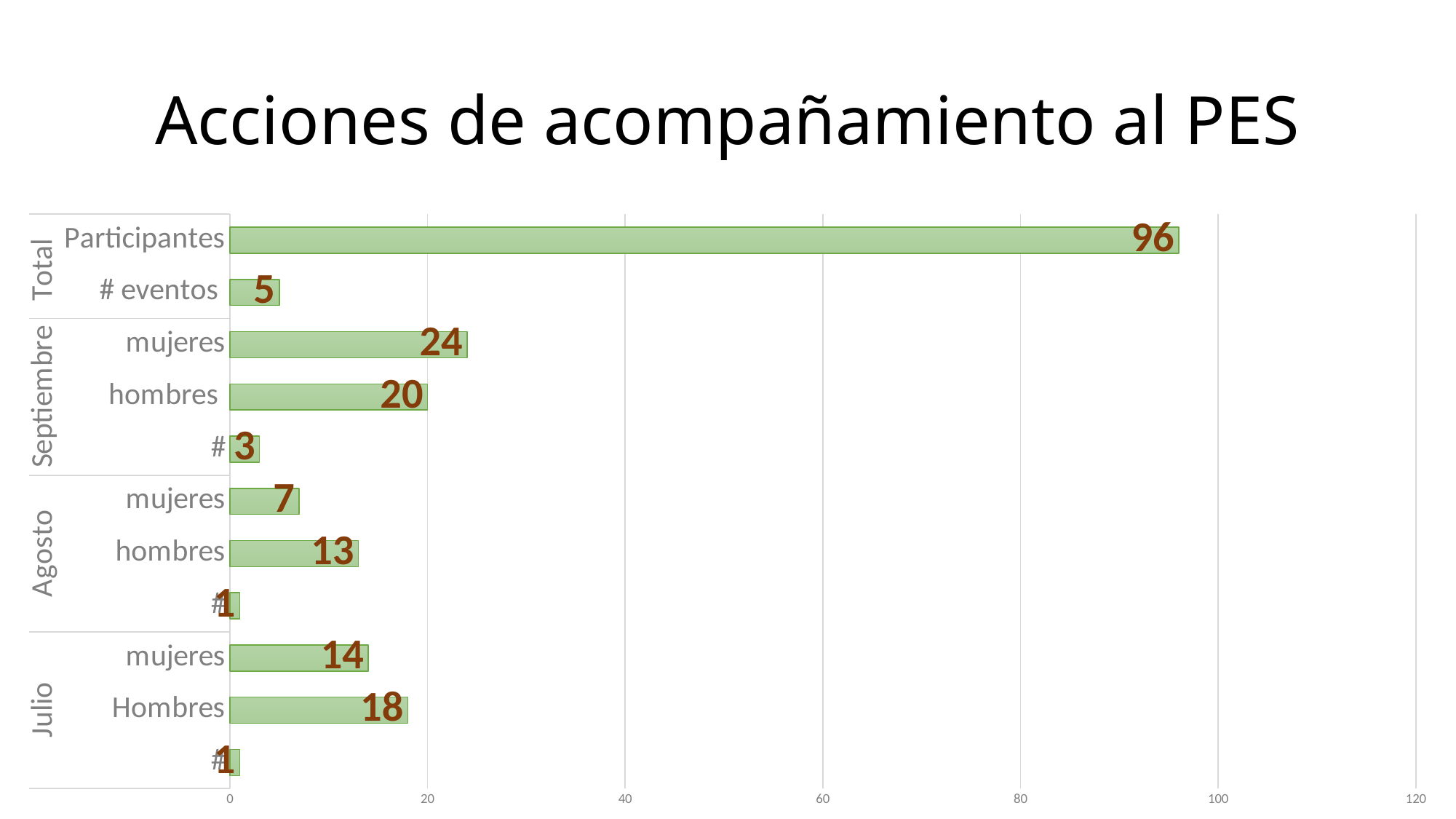
What is the difference between mujeres and hombres in Septiembre? 4 What is the value for hombres in Agosto? 13 What kind of chart is shown on the slide? bar chart How many bars are plotted in the chart? 11 What is the value for # eventos under Total? 5 Which is larger in Agosto, mujeres or hombres? hombres Is the value for Participantes greater or less than 80? greater Which category has the highest value? Participantes What is the value for Hombres in Julio? 18 Which is larger, mujeres in Julio or mujeres in Septiembre? mujeres in Septiembre What is the value for Participantes under Total? 96 What is the value for mujeres in Septiembre? 24